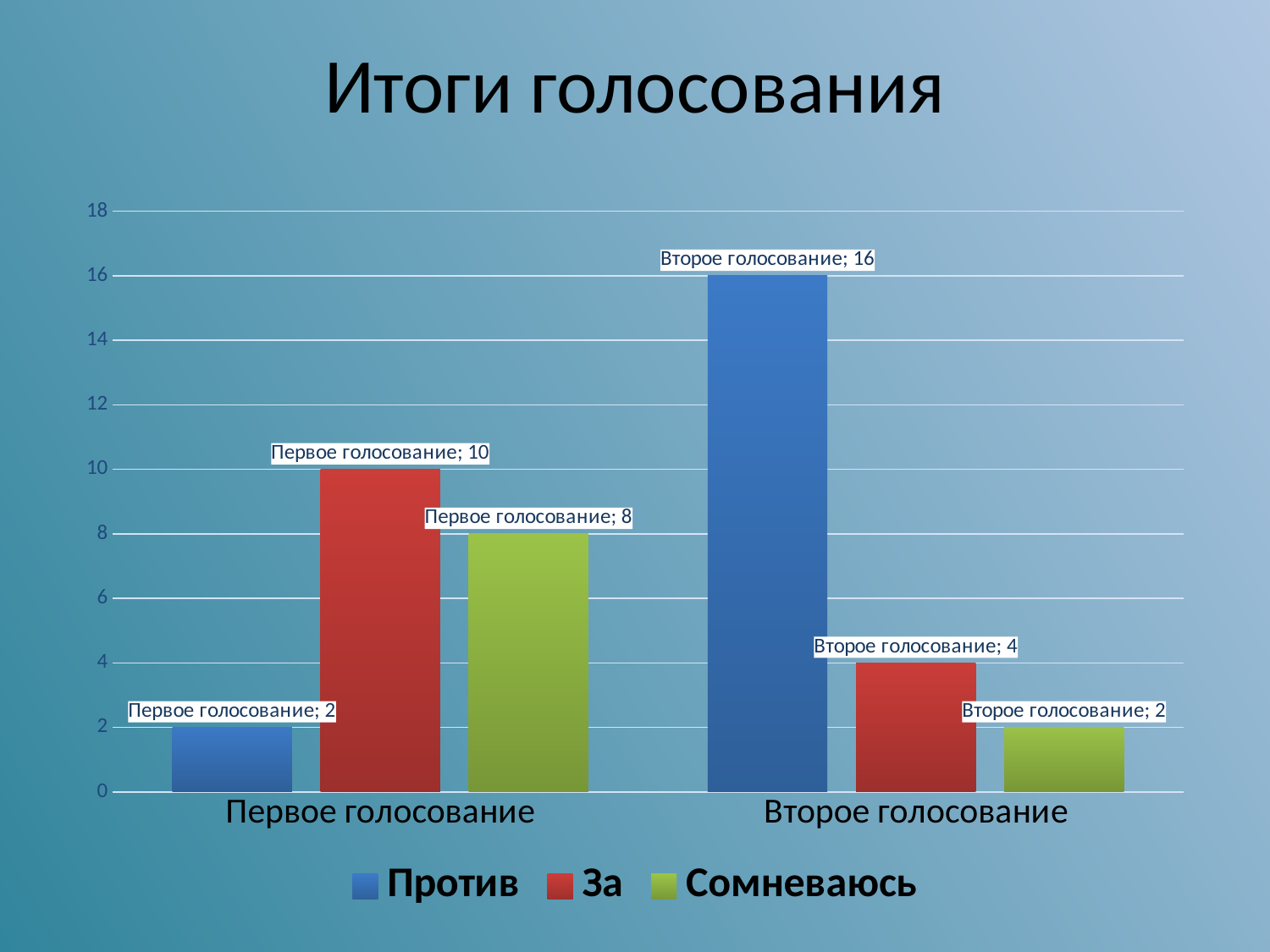
What is the value for Сомневаюсь in Второе голосование? 2 What is the value for За in Первое голосование? 10 Which series has the highest value in Второе голосование? Против How many series does the legend list? 3 How many categories are shown on the x axis? 2 What is the value for Против in Второе голосование? 16 What is the title of the slide? Итоги голосования What is the value for Против in Первое голосование? 2 What kind of chart is shown on the slide? Bar chart Which is larger: За in Первое голосование or За in Второе голосование? За in Первое голосование Which series has the lowest value in Первое голосование? Против What is the difference between Против in Второе голосование and Против in Первое голосование? 14